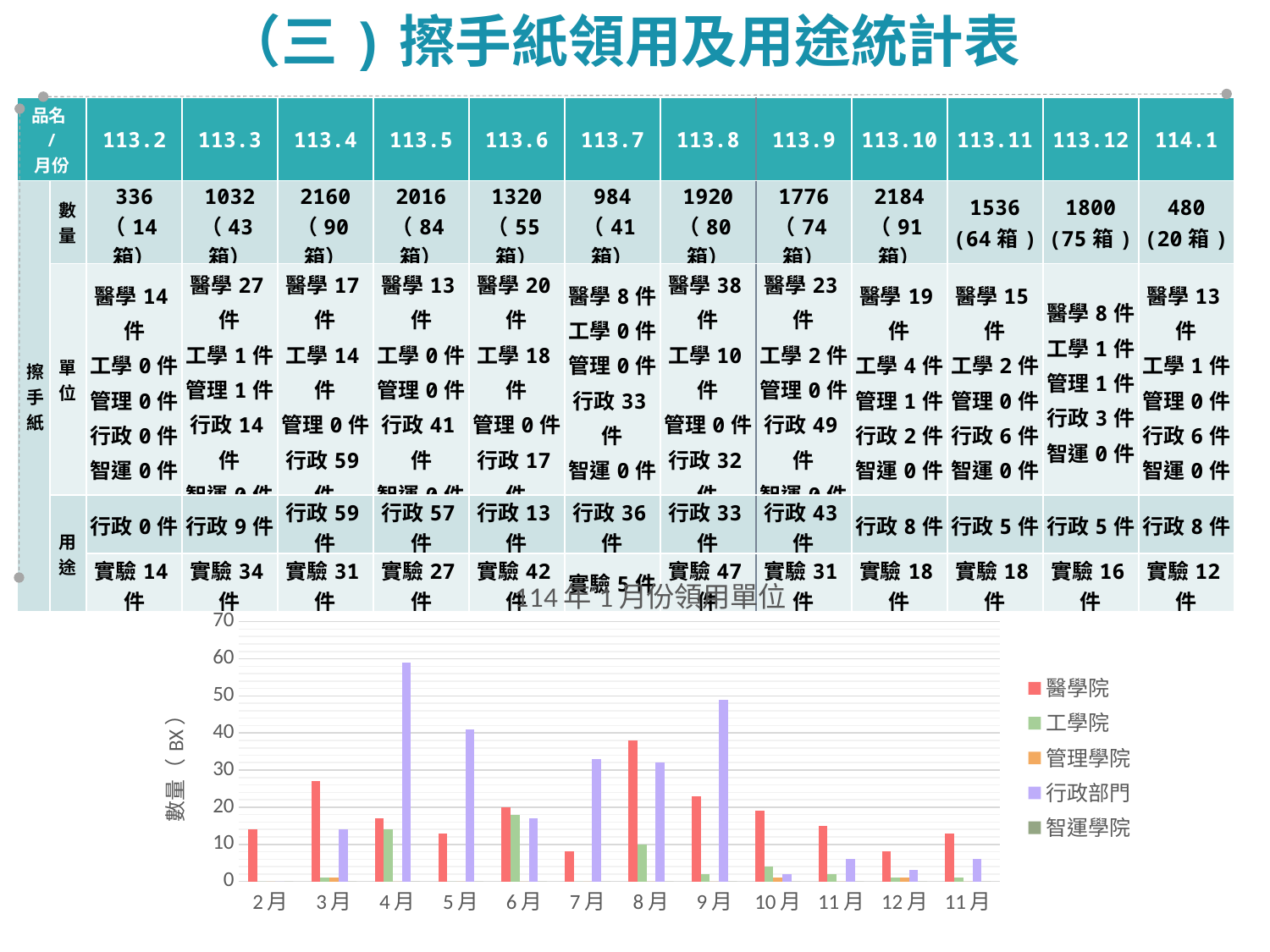
Is the value for 行政部門 in 4月 greater or less than 50? greater Is the value for 行政部門 in 9月 greater or less than 40? greater How many month categories are shown on the x axis of the chart? 12 Is the value for 醫學院 in 7月 greater or less than 10? less Does the 醫學院 value rise or fall from 7月 to 8月? rise In which month is the 行政部門 bar the tallest? 4月 In which month is the 醫學院 bar the tallest? 8月 What is the title of the chart's vertical axis? 數量（BX） In 7月, which is larger: the 醫學院 bar or the 行政部門 bar? 行政部門 How many series does the chart legend list? 5 What kind of chart is shown on the slide? bar chart In 3月, which is larger: the 醫學院 bar or the 行政部門 bar? 醫學院